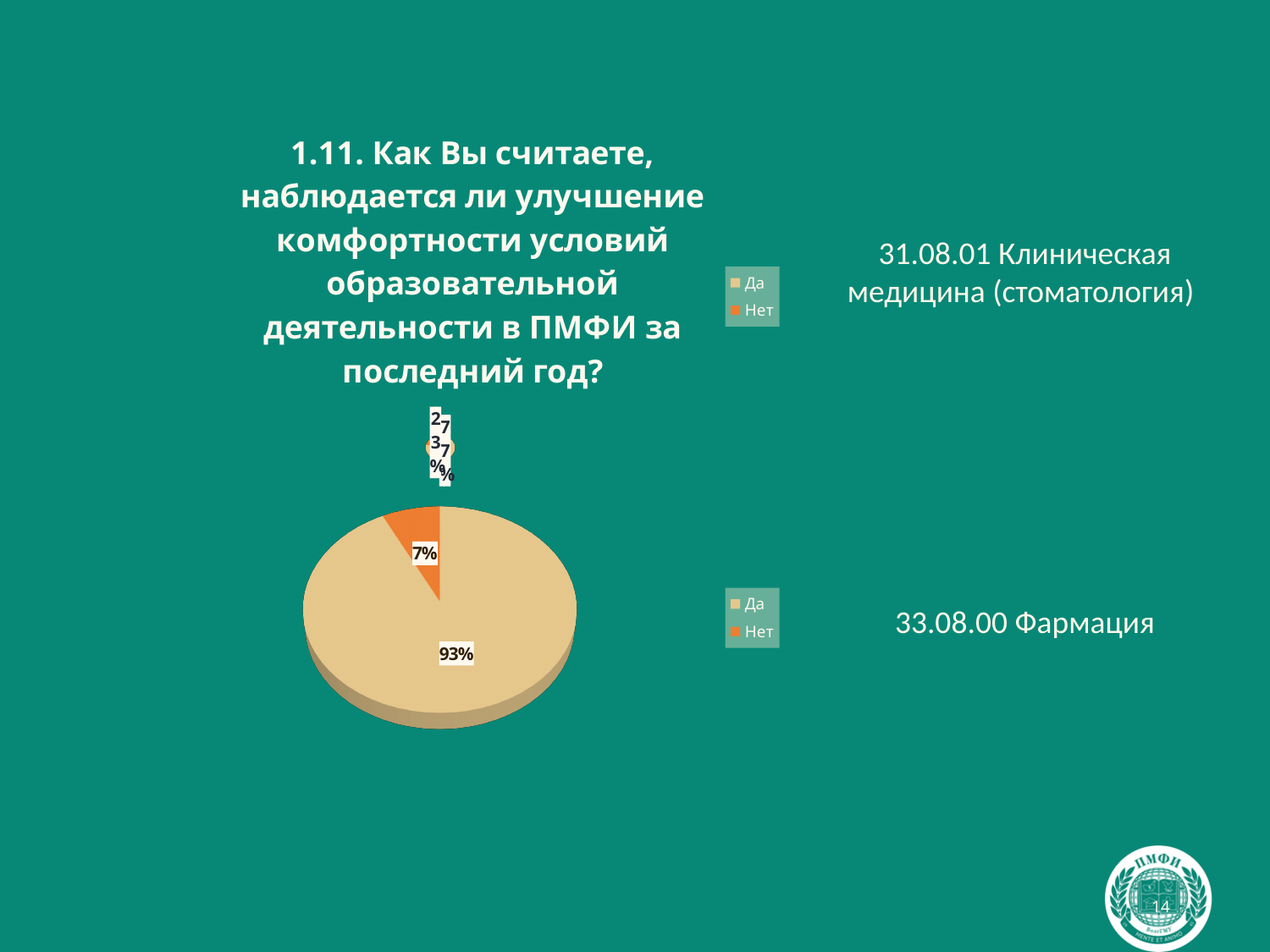
In the pie chart for 33.08.00 Фармация, which answer has the largest slice? Да In the pie chart for 33.08.00 Фармация, what share of respondents answered Нет? 7% How many entries does the legend next to the 33.08.00 Фармация chart list? 2 What type of chart is used for 33.08.00 Фармация? Pie chart In the pie chart for 33.08.00 Фармация, what colour is the slice for Нет? Orange What are the two answer options listed in the legends on the slide? Да and Нет In the pie chart for 33.08.00 Фармация, which is larger: the share for Да or the share for Нет? Да In the pie chart for 33.08.00 Фармация, by how many percentage points does Да exceed Нет? 86 percentage points In the pie chart for 33.08.00 Фармация, how many slices does the pie have? 2 In the pie chart for 33.08.00 Фармация, what share of respondents answered Да? 93% In the pie chart for 33.08.00 Фармация, which answer has the smallest slice? Нет